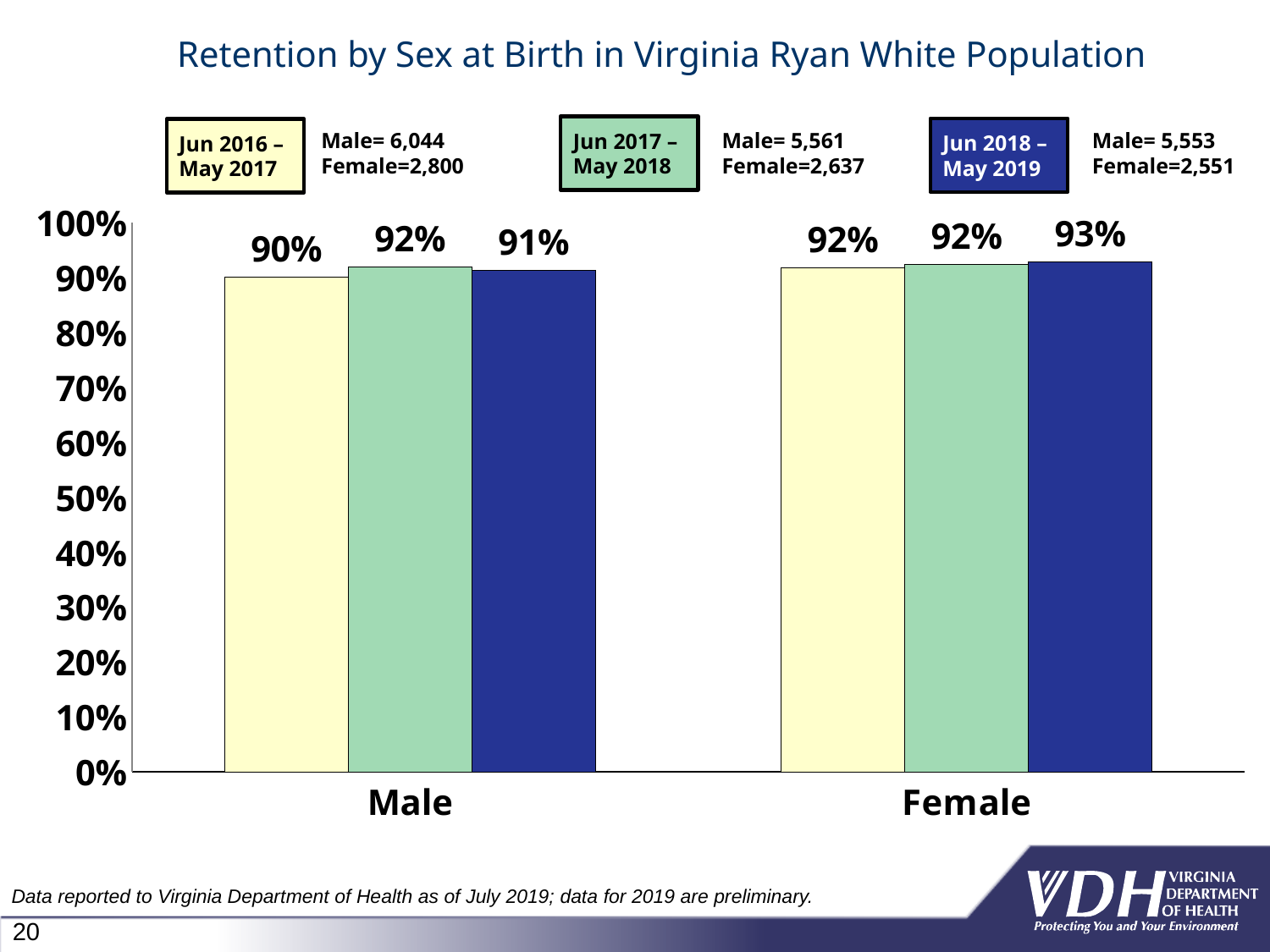
What is the retention value for Male in Jun 2016 – May 2017? 90% What is the difference between the Female and Male retention values in Jun 2018 – May 2019? 2% Which has the higher retention value in Jun 2016 – May 2017, Male or Female? Female What is the retention value for Male in Jun 2017 – May 2018? 92% How many time periods (series) are shown in the legend? 3 How many categories are shown on the x axis? 2 What is the title of the chart? Retention by Sex at Birth in Virginia Ryan White Population What type of chart is shown on the slide? Bar chart What is the retention value for Female in Jun 2016 – May 2017? 92% What is the difference between the Male retention values in Jun 2017 – May 2018 and Jun 2016 – May 2017? 2% What is the retention value for Female in Jun 2018 – May 2019? 93% Is the retention value for Male in Jun 2018 – May 2019 greater or less than 80%? greater